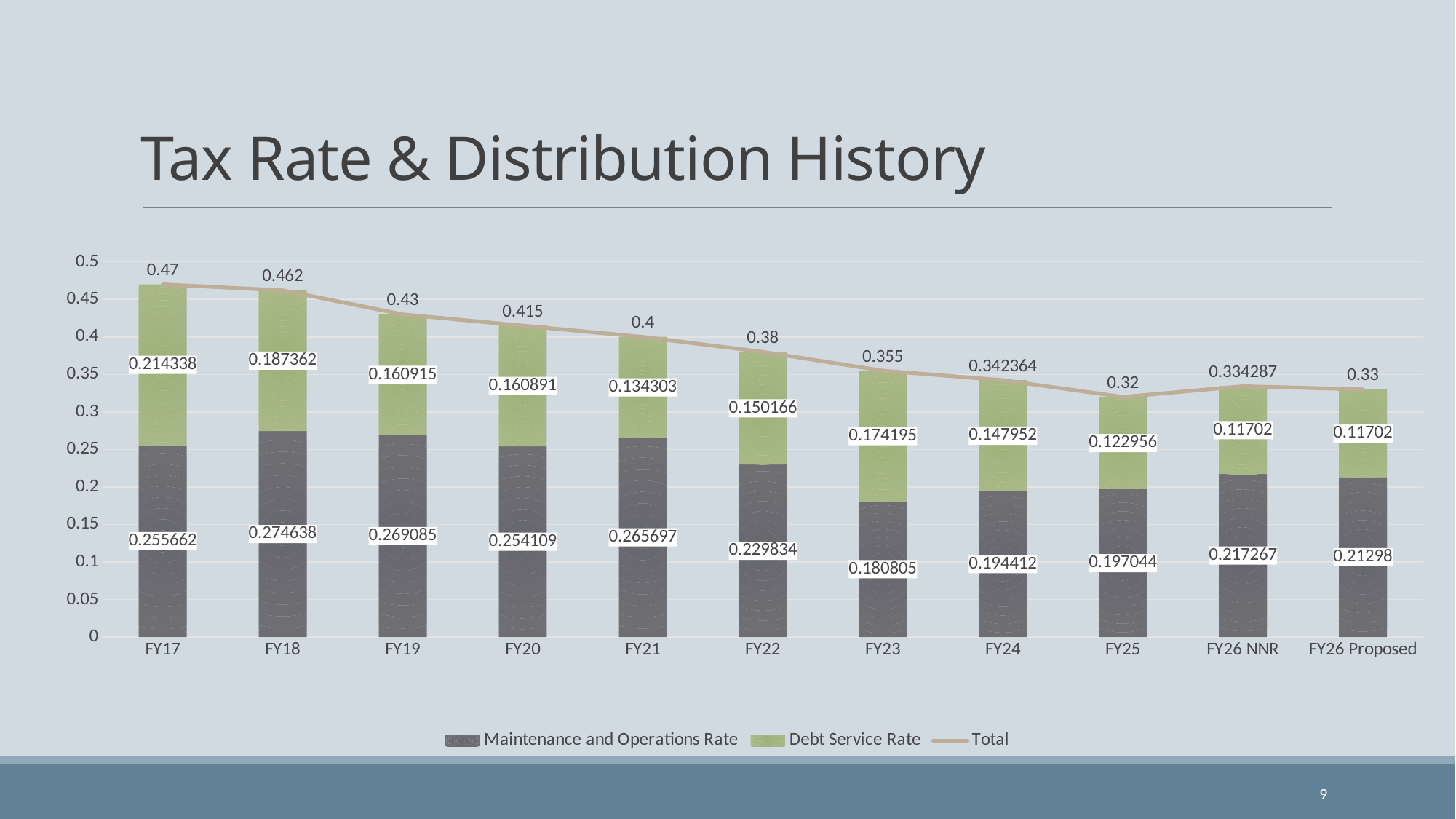
Which fiscal year has the lowest Total? FY25 Which fiscal year has the highest Total? FY17 What is the Maintenance and Operations Rate for FY18? 0.274638 What is the difference between the Total for FY17 and the Total for FY25? 0.15 Does the Total line generally rise or fall from FY17 to FY25? fall How many series does the legend list? 3 What is the Debt Service Rate for FY22? 0.150166 What is the Total value shown for FY24? 0.342364 Which is larger, the Maintenance and Operations Rate for FY23 or the Debt Service Rate for FY23? Maintenance and Operations Rate What kind of chart is shown on the slide? Stacked bar chart with a line How many fiscal year categories are shown on the x axis? 11 Is the Total for FY19 greater or less than 0.4? greater